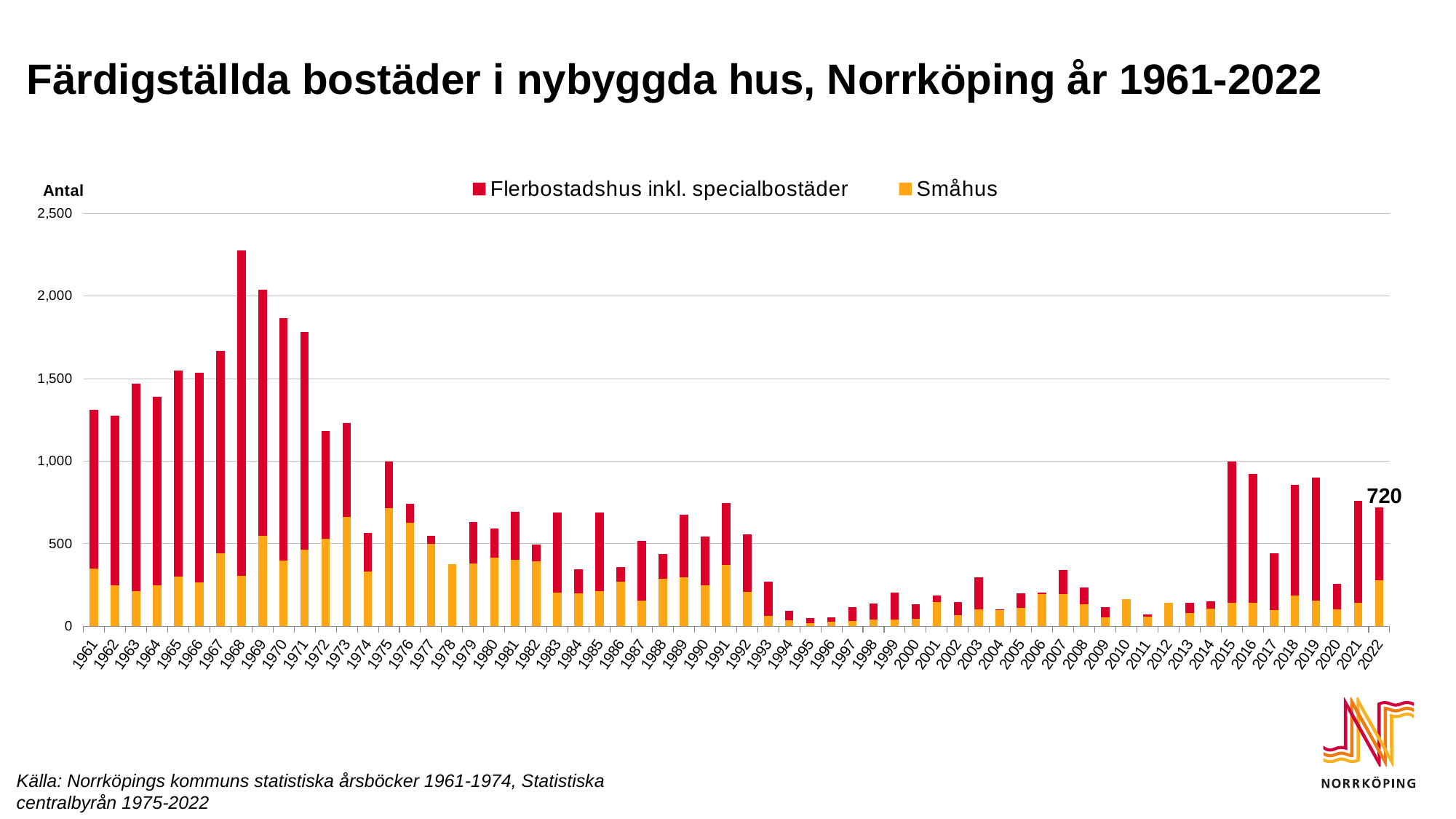
Do the total values rise or fall from 1968 to 1978? Fall Which year has the highest total bar in the chart? 1968 What kind of chart is shown on the slide? Stacked bar chart What is the total number of completed dwellings shown for 2022? 720 Is the total value for 1968 greater or less than 2,000? greater Which year has the larger total bar, 2015 or 2020? 2015 Which series is shown in orange in the legend? Småhus How many series does the legend list? 2 How many years are shown on the x axis? 62 Which year has the larger total bar, 1968 or 1969? 1968 Is the total value for 1973 greater or less than 1,000? greater Is the total value for 2004 greater or less than 500? less